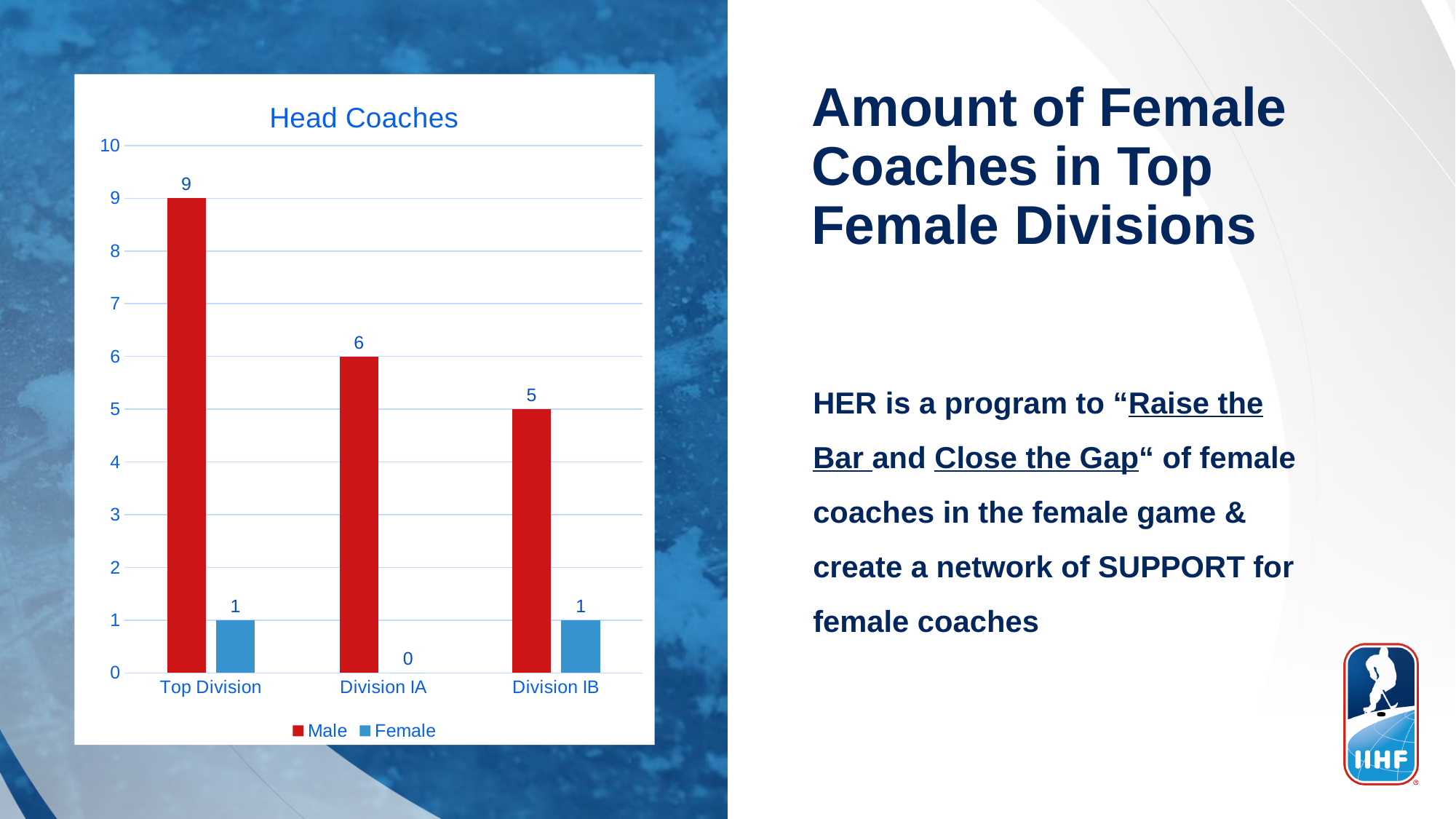
Which division has the highest number of male head coaches? Top Division Which division has the lowest number of female head coaches? Division IA How many male head coaches are there in the Top Division? 9 Do the male head coach values rise or fall from Top Division to Division IB? fall How many divisions are shown on the x axis? 3 Which is larger, the number of male head coaches in Division IA or in Division IB? Division IA How many series does the legend list? 2 What is the difference between male and female head coaches in the Top Division? 8 What type of chart is shown on the slide? bar chart How many male head coaches are there in Division IB? 5 How many female head coaches are there in Division IA? 0 What is the title of the chart? Head Coaches